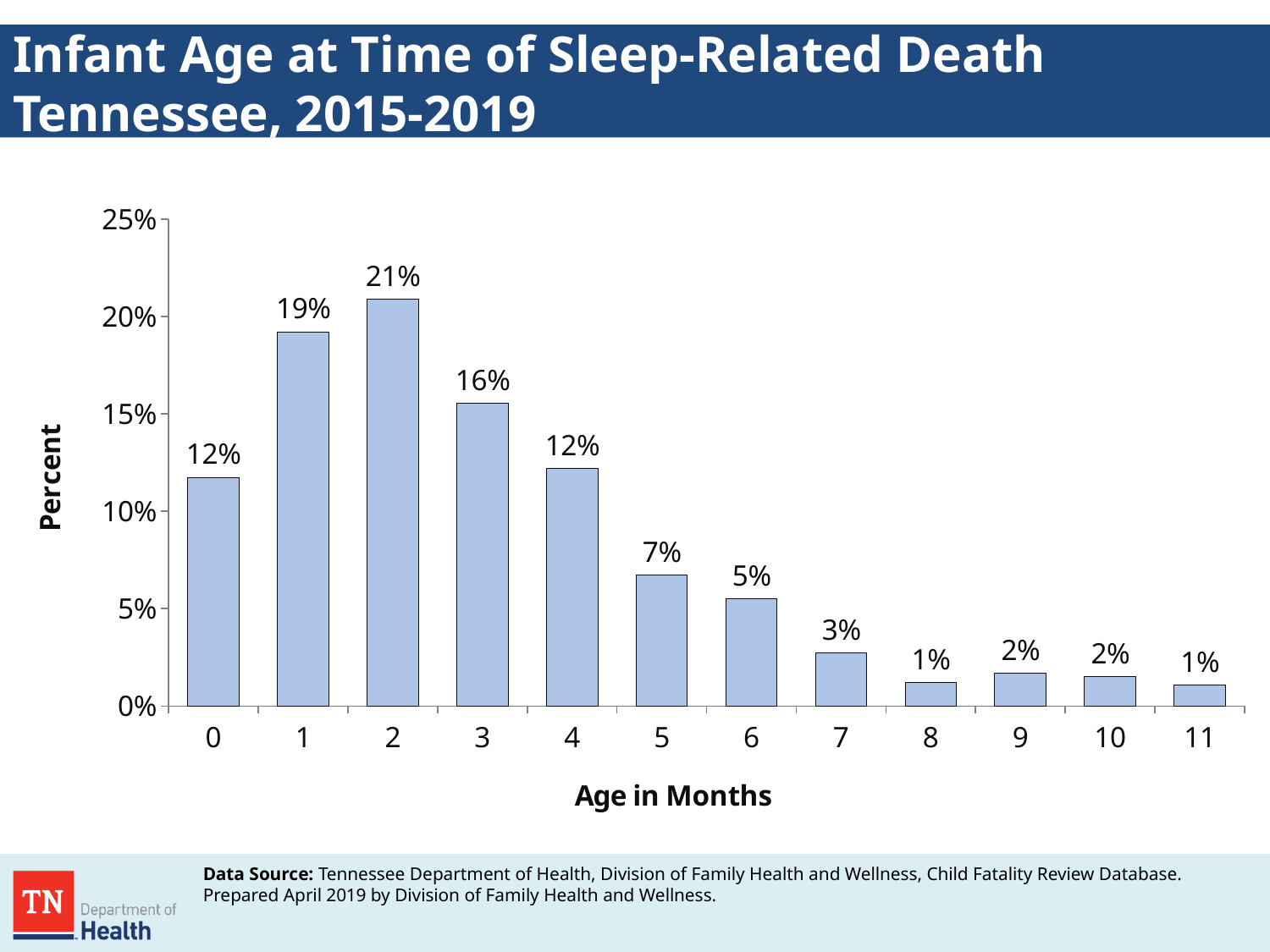
What percent of sleep-related deaths occurred at age 2 months? 21% Which age in months has the highest percent of sleep-related deaths? 2 What kind of chart is shown on the slide? Bar chart What is the value shown for age 7 months? 3% How many age categories are shown on the x axis? 12 What is the label of the y axis? Percent What is the difference in percent between age 2 months and age 5 months? 14% Is the value for age 3 months greater or less than 15%? greater Do the values generally rise or fall from age 2 months to age 11 months? Fall What is the difference in percent between age 1 month and age 3 months? 3% Which has a higher percent, age 4 months or age 6 months? 4 months What percent of sleep-related deaths occurred at age 0 months? 12%